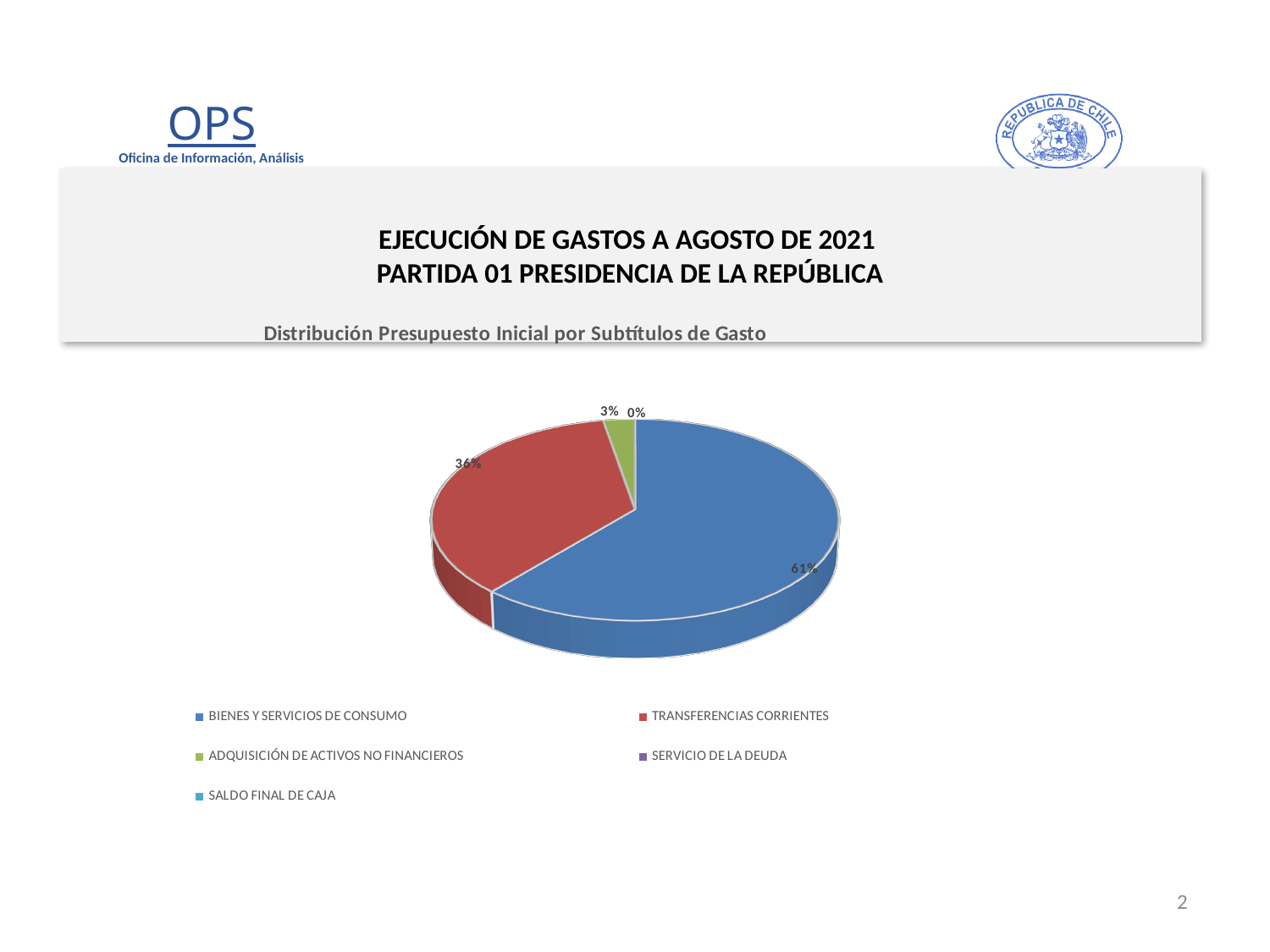
What share of the pie does TRANSFERENCIAS CORRIENTES represent? 36% What share of the pie does BIENES Y SERVICIOS DE CONSUMO represent? 61% What type of chart is shown on the slide? Pie chart What is the difference in percentage points between the BIENES Y SERVICIOS DE CONSUMO slice and the TRANSFERENCIAS CORRIENTES slice? 25 percentage points Is the share for BIENES Y SERVICIOS DE CONSUMO greater or less than 50%? greater Which is larger, the slice for TRANSFERENCIAS CORRIENTES or the slice for ADQUISICIÓN DE ACTIVOS NO FINANCIEROS? TRANSFERENCIAS CORRIENTES What is the title of the chart? Distribución Presupuesto Inicial por Subtítulos de Gasto Which category has the largest slice of the pie? BIENES Y SERVICIOS DE CONSUMO What share of the pie does ADQUISICIÓN DE ACTIVOS NO FINANCIEROS represent? 3% How many categories does the legend of the chart list? 5 What colour is the slice for TRANSFERENCIAS CORRIENTES? Red